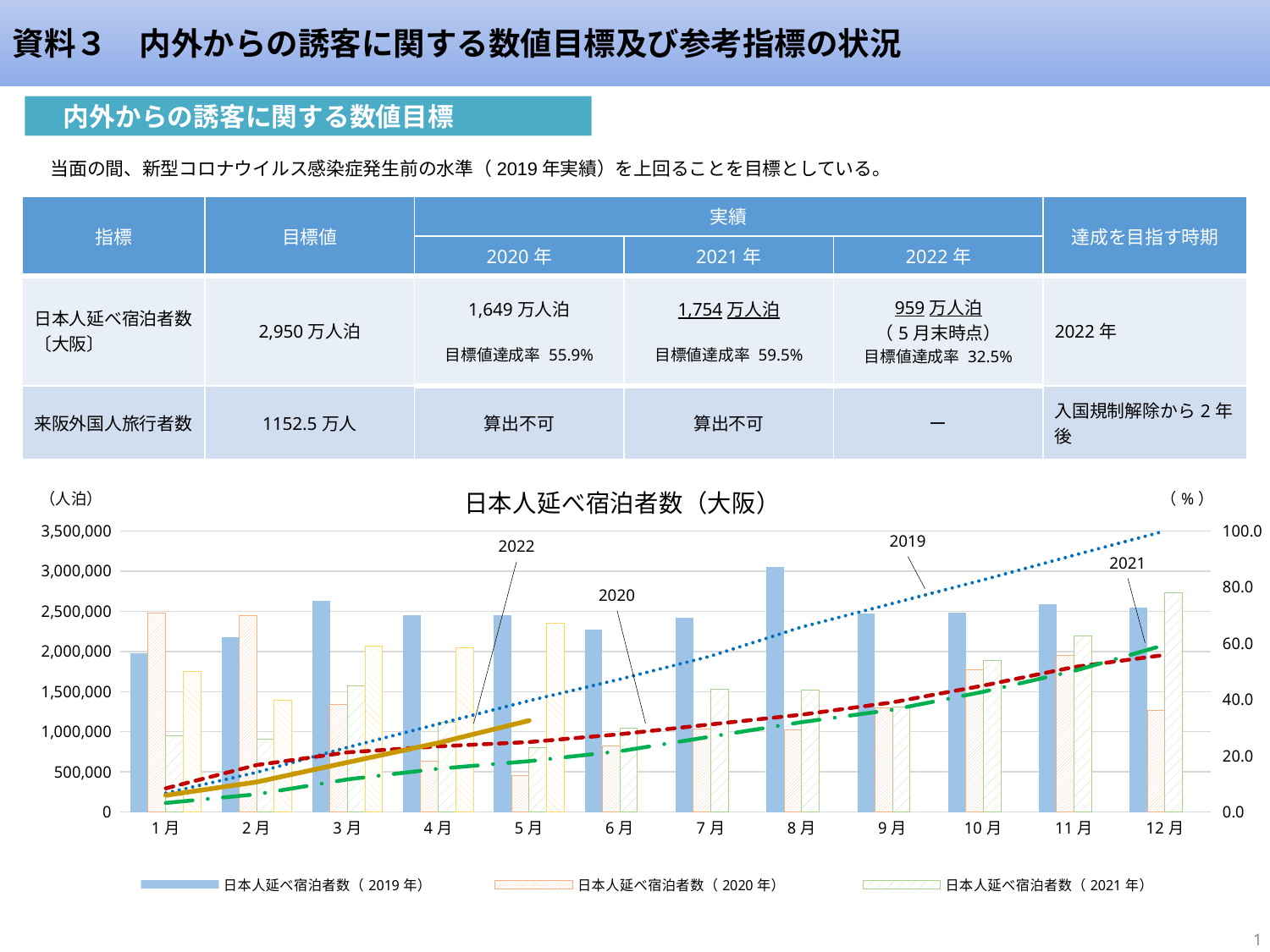
In which month is the 2019 bar (日本人延べ宿泊者数（2019年）) the highest? 8月 Which is larger in 1月: the 2019 bar or the 2021 bar? The 2019 bar How many months are shown along the x axis of the chart? 12 How many series does the chart legend list? 3 What is the title of the chart? 日本人延べ宿泊者数（大阪） In which month is the 2021 bar (日本人延べ宿泊者数（2021年）) the highest? 12月 What kind of chart is shown on the slide? A bar chart combined with line series Is the 2019 bar for 8月 greater or less than 2,500,000? greater Is the 2021 bar for 12月 greater or less than 2,500,000? greater Does the dotted 2019 line rise or fall from 1月 to 12月? It rises Is the 2020 bar for 5月 greater or less than 1,000,000? less In which month is the 2020 bar (日本人延べ宿泊者数（2020年）) the lowest? 5月